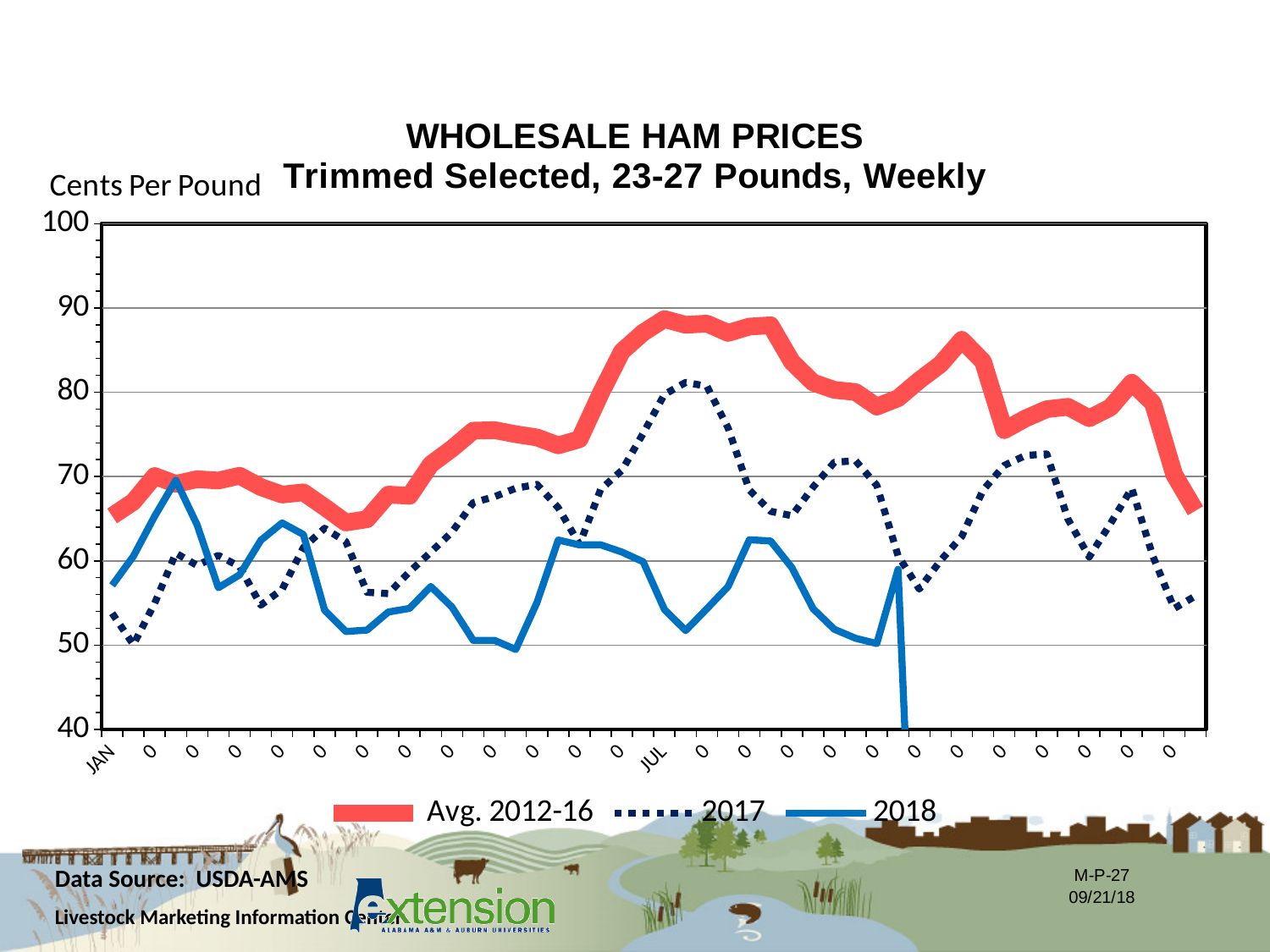
Does the Avg. 2012-16 series rise or fall from JAN to JUL? rise What kind of chart is shown on the slide? line chart What unit is shown on the vertical axis label? Cents Per Pound How many series does the legend list? 3 Is the value of the 2017 series at JAN greater or less than 60? less At JAN, which is higher: the Avg. 2012-16 series or the 2018 series? Avg. 2012-16 What are the three series listed in the legend? Avg. 2012-16, 2017, 2018 At JUL, which is higher: the Avg. 2012-16 series or the 2017 series? Avg. 2012-16 Is the value of the Avg. 2012-16 series at JAN greater or less than 60? greater Is the value of the Avg. 2012-16 series at JUL greater or less than 80? greater Which series reaches the highest value on the chart? Avg. 2012-16